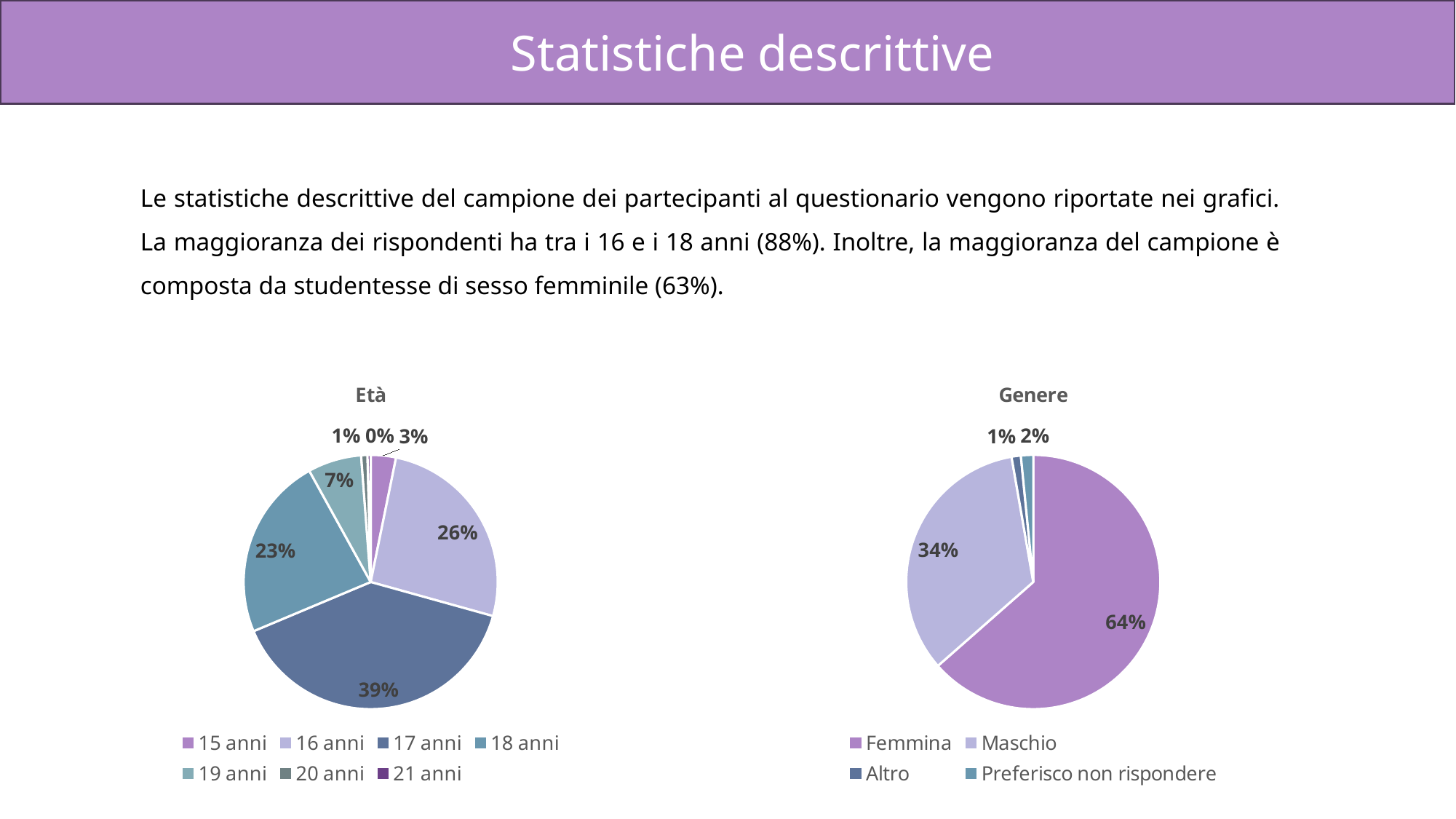
In the Genere chart, what is the difference between the Femmina and Maschio shares? 30% In the Età chart, what is the difference between the 17 anni and 18 anni shares? 16% In the Età chart, how many age categories does the legend list? 7 In the Età chart, which age group has the largest slice? 17 anni In the Genere chart, which category has the largest slice? Femmina What kind of chart is the Genere chart? Pie chart In the Genere chart, what share of respondents are Femmina? 64% In the Età chart, what share of respondents are 18 anni? 23% In the Età chart, what share of respondents are 17 anni? 39% In the Genere chart, what share of respondents are Maschio? 34% In the Genere chart, how many categories does the legend list? 4 In the Età chart, what share of respondents are 16 anni? 26%